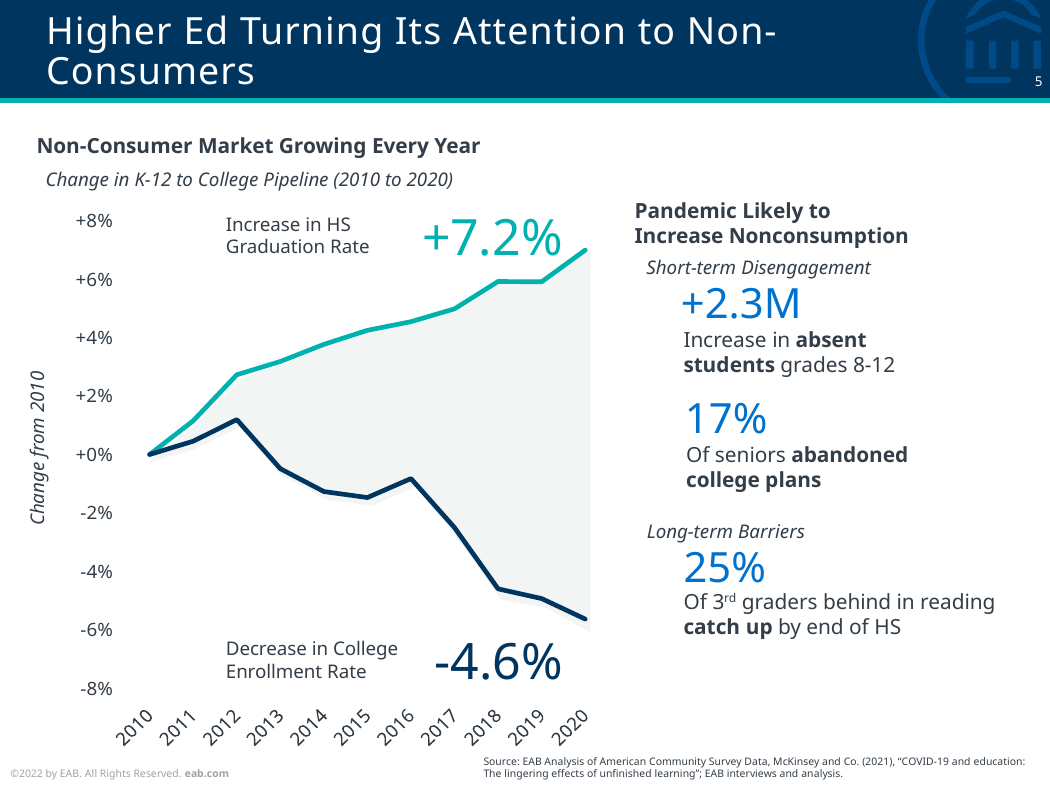
Does the college enrollment rate line rise or fall overall from 2012 to 2020? fall How many years are shown along the x axis of the chart? 11 What is the labeled change in the HS graduation rate by 2020? +7.2% Does the HS graduation rate line rise or fall from 2010 to 2020? rise What is the labeled change in the college enrollment rate shown at the end of the chart? -4.6% What is the difference in percentage points between the labeled +7.2% HS graduation rate change and the labeled -4.6% college enrollment rate change? 11.8 percentage points Is the college enrollment rate change in 2018 greater or less than -4%? less Is the college enrollment rate change in 2016 greater or less than -2%? greater How many data series are plotted on the chart? 2 What kind of chart is shown on the slide? line chart What is the label of the y axis on the chart? Change from 2010 Is the HS graduation rate change in 2017 greater or less than +4%? greater